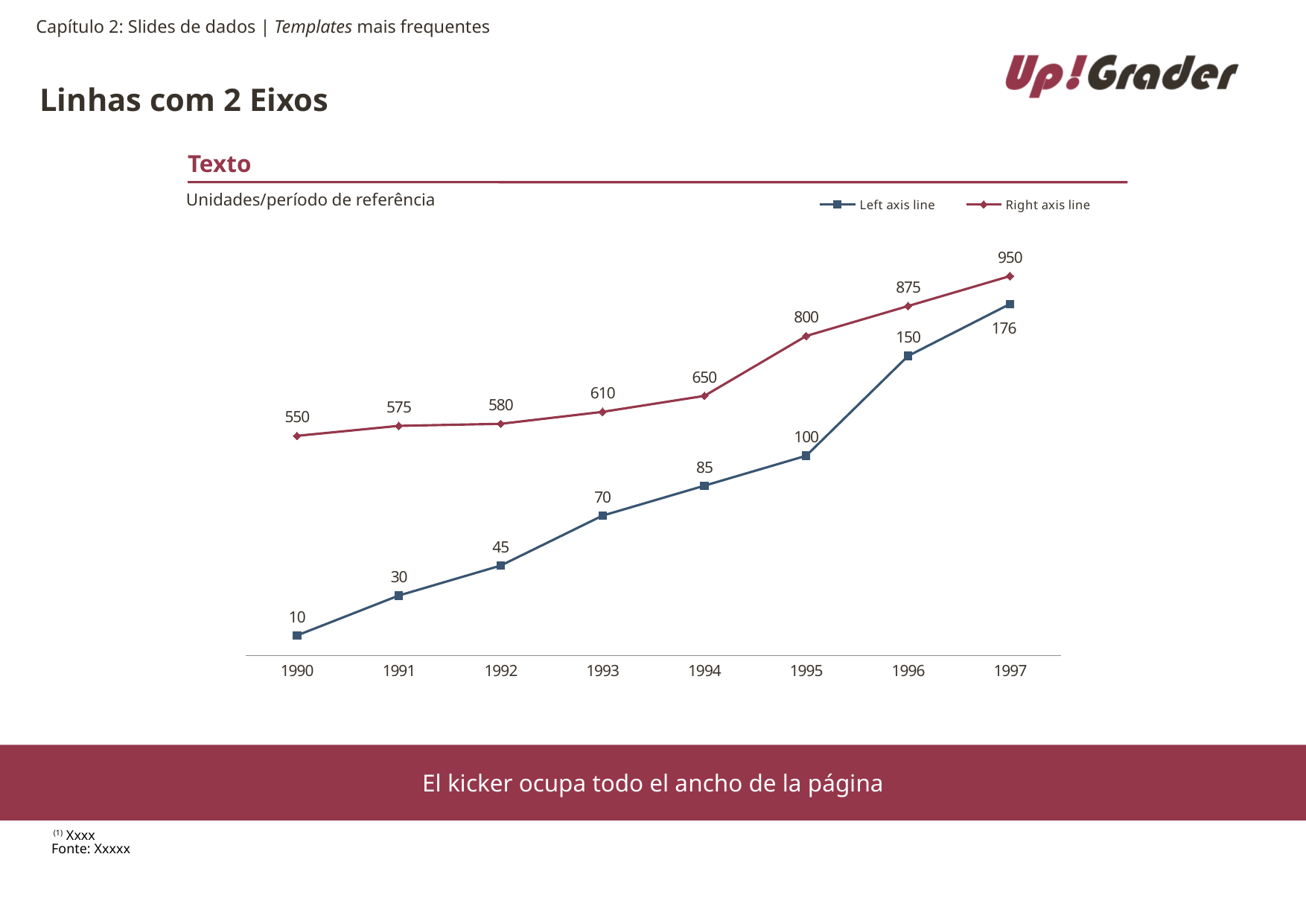
What is the difference between the Right axis line values in 1997 and 1996? 75 What is the difference between the Left axis line values in 1996 and 1995? 50 In which year is the Left axis line at its lowest? 1990 What is the value of the Right axis line in 1995? 800 How many series does the legend list? 2 How many years are shown on the x axis? 8 Which is larger: the Left axis line value in 1994 or in 1995? 1995 What is the value of the Left axis line in 1997? 176 What kind of chart is shown on the slide? Line chart In which year is the Right axis line at its highest? 1997 What is the value of the Left axis line in 1993? 70 Do the Left axis line values rise or fall from 1990 to 1997? Rise